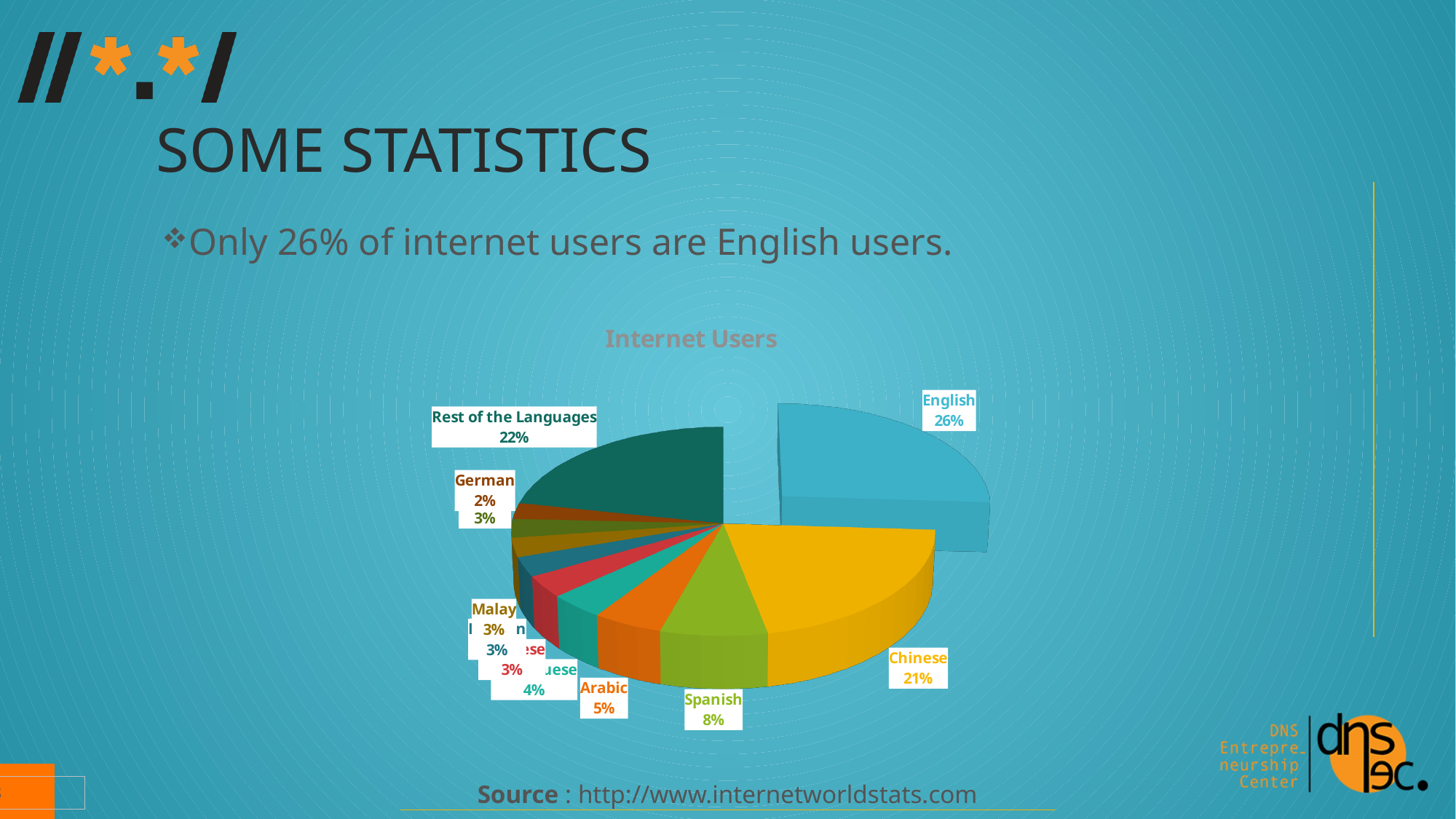
Which language has the largest share of internet users in the chart? English What kind of chart is shown on the slide? pie chart What is the title of the chart? Internet Users How many percentage points larger is the English share than the Chinese share? 5 percentage points What percentage is shown for Malay? 3% What percentage is shown for Spanish? 8% What percentage is shown for German? 2% What percentage is shown for Rest of the Languages? 22% What share of internet users does the English slice represent? 26% What percentage is shown for Arabic? 5% What percentage is shown for Chinese? 21% Which slice is larger, Spanish or Arabic? Spanish